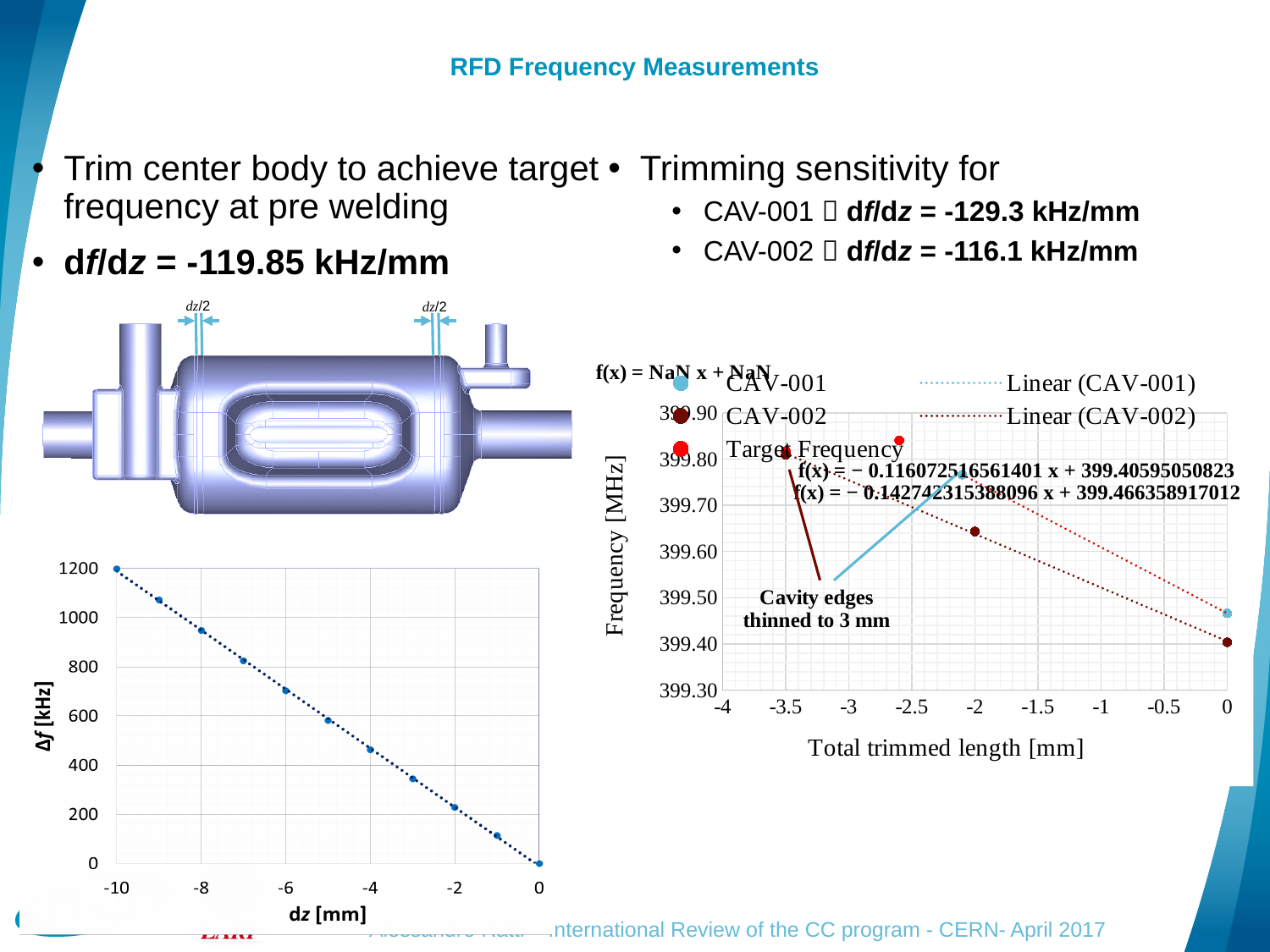
In the right-hand chart, is the CAV-001 frequency at 0 mm total trimmed length greater or less than 399.50 MHz? less In the right-hand chart, is the Target Frequency point greater or less than 399.70 MHz? greater How many data points are plotted in the bottom-left chart? 11 What kind of chart is the bottom-left chart with dz on the x axis? scatter chart In the bottom-left chart, at which dz value is Δf highest? -10 In the bottom-left chart, what is the value of Δf at dz = 0 mm? 0 In the bottom-left chart, is the value of Δf at dz = -8 greater or less than 800? greater In the right-hand chart, at 0 mm total trimmed length, which has the higher frequency, CAV-001 or CAV-002? CAV-001 What is the x-axis title of the right-hand chart? Total trimmed length [mm] How many series does the legend of the right-hand chart (Frequency vs Total trimmed length) list? 5 In the bottom-left chart, does Δf rise or fall as dz increases from -10 to 0? fall